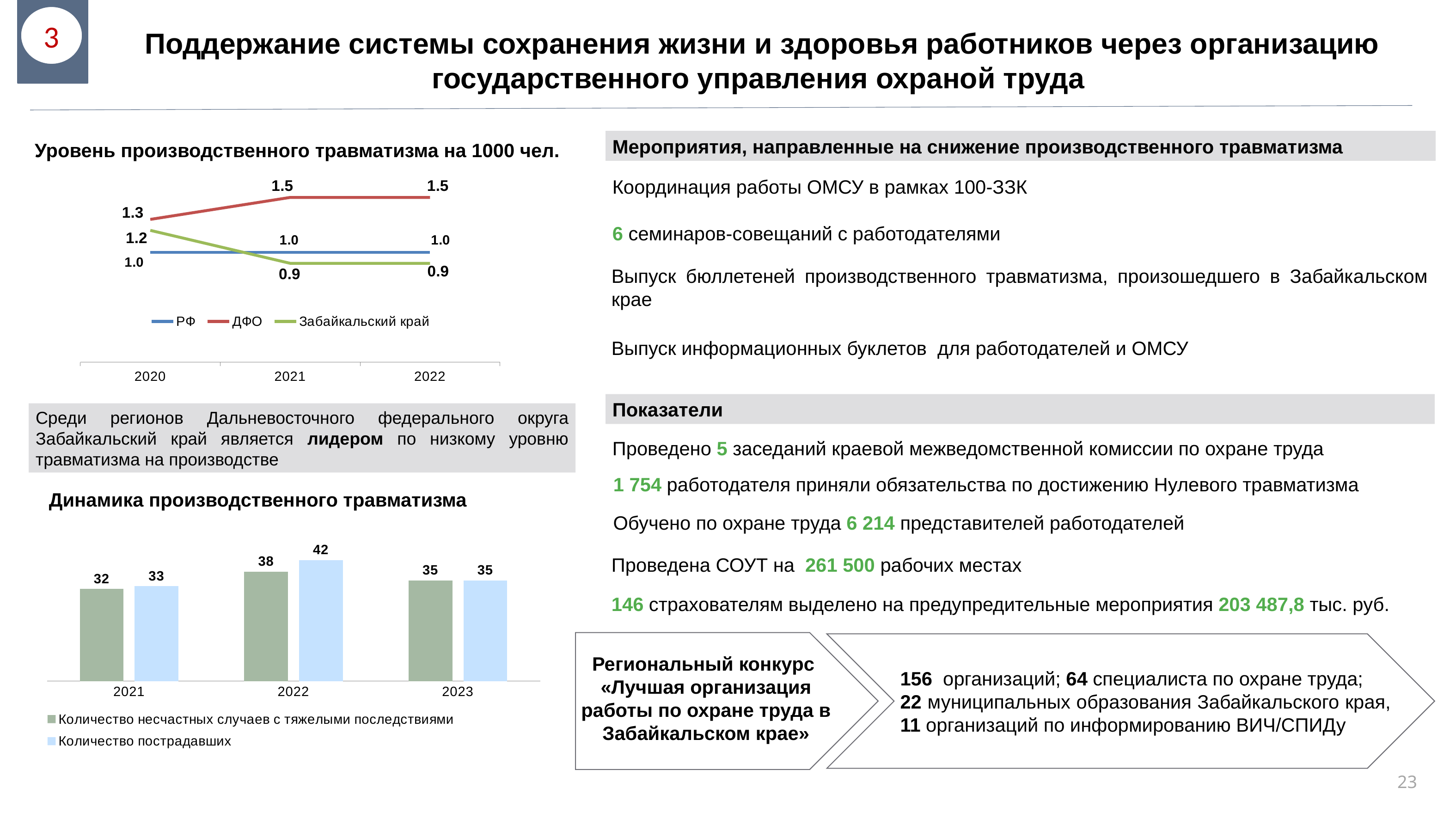
How many series does the legend of the chart 'Уровень производственного травматизма на 1000 чел.' list? 3 In the chart 'Уровень производственного травматизма на 1000 чел.', which series has the highest value in 2022? ДФО In the chart 'Уровень производственного травматизма на 1000 чел.', what is the value for Забайкальский край in 2020? 1.2 In the chart 'Уровень производственного травматизма на 1000 чел.', what is the value for ДФО in 2021? 1.5 In the chart 'Динамика производственного травматизма', in which year is 'Количество несчастных случаев с тяжелыми последствиями' highest? 2022 In the chart 'Уровень производственного травматизма на 1000 чел.', which series has the lowest value in 2022? Забайкальский край What kind of chart is 'Динамика производственного травматизма'? bar chart In the chart 'Уровень производственного травматизма на 1000 чел.', does the Забайкальский край series rise or fall from 2020 to 2021? fall In the chart 'Уровень производственного травматизма на 1000 чел.', what is the difference between ДФО and Забайкальский край in 2021? 0.6 In the chart 'Динамика производственного травматизма', what is the difference between 'Количество пострадавших' and 'Количество несчастных случаев с тяжелыми последствиями' in 2022? 4 How many years are shown on the x axis of the chart 'Динамика производственного травматизма'? 3 In the chart 'Динамика производственного травматизма', what is the value of 'Количество пострадавших' in 2022? 42